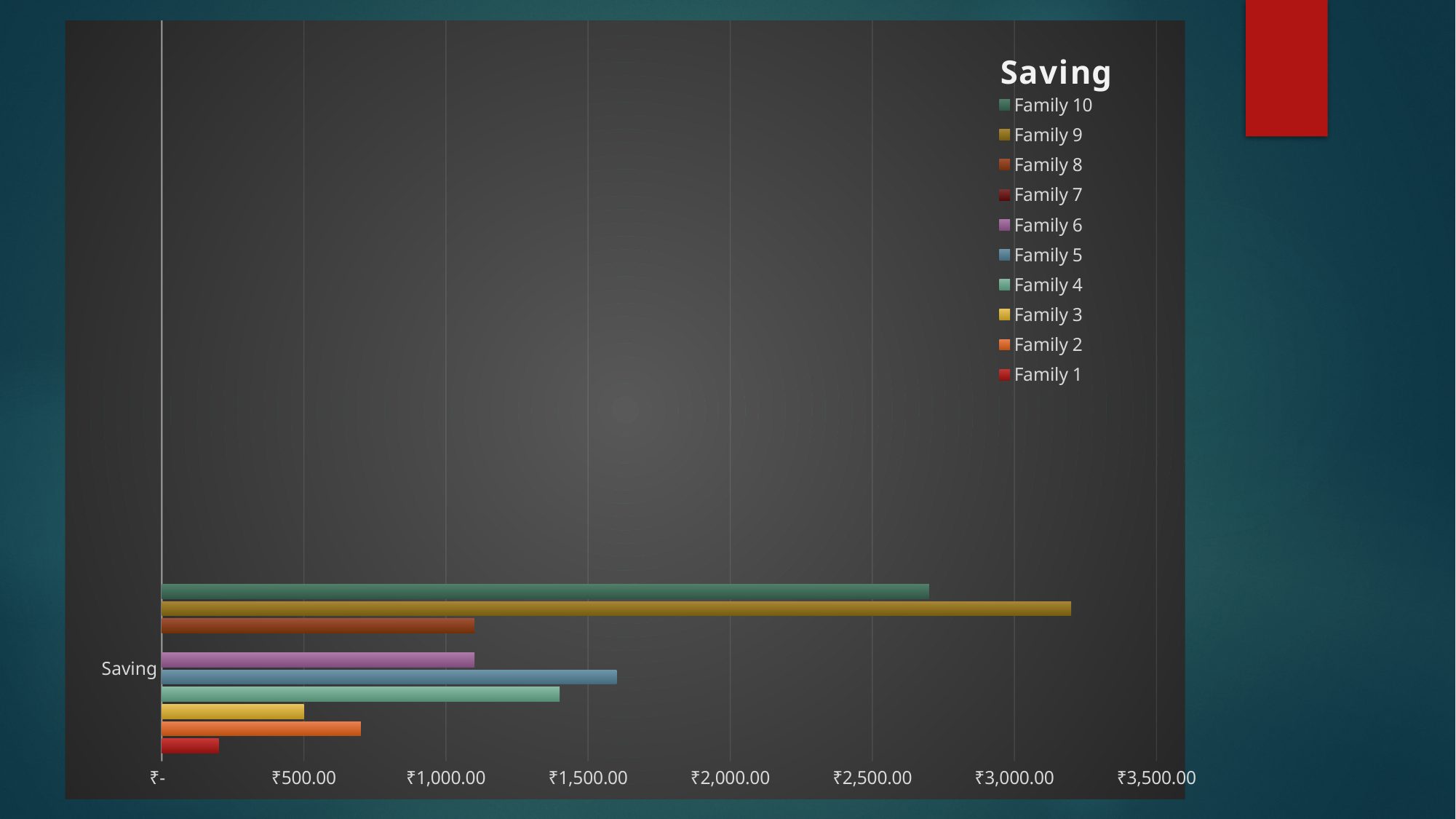
What kind of chart is shown on the slide? bar chart Is the saving for Family 4 greater or less than ₹1,500.00? less What is the title of the chart? Saving Is the saving for Family 1 greater or less than ₹500.00? less Which has a larger saving, Family 2 or Family 1? Family 2 How many categories are shown on the vertical axis? 1 Which family has the highest saving? Family 9 Is the saving for Family 8 greater or less than ₹1,000.00? greater How many series does the legend list? 10 Which has a larger saving, Family 9 or Family 10? Family 9